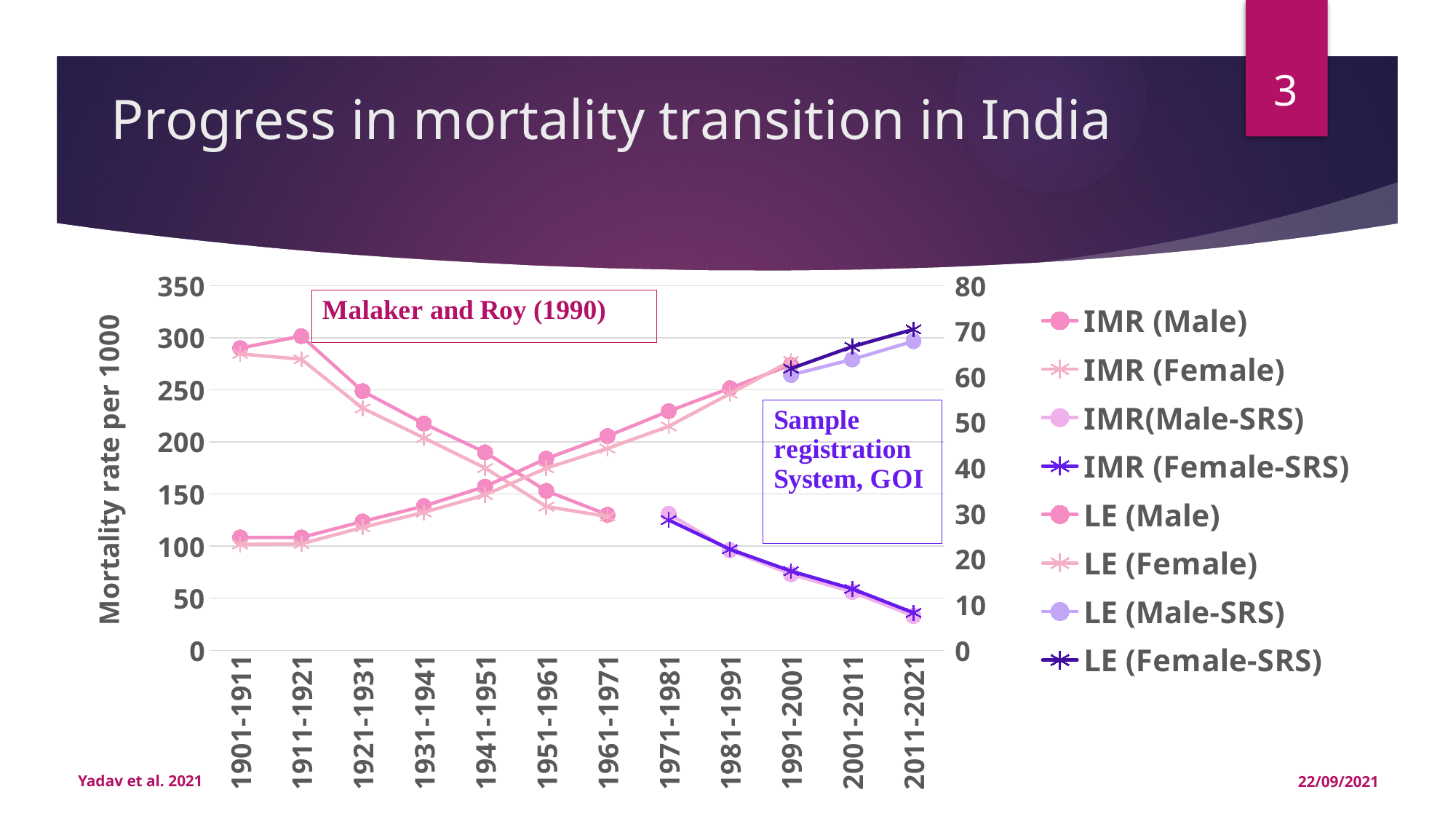
Is the IMR (Female) value for 1961-1971 greater or less than 150 on the left axis? less Is the IMR (Male) value for 1901-1911 greater or less than 250 on the left axis? greater Does the LE (Male) series rise or fall from 1901-1911 to 1991-2001? rise How many series does the legend list? 8 Is the IMR (Male) value for 1941-1951 greater or less than 200 on the left axis? less What source is named in the annotation box at the top of the chart? Malaker and Roy (1990) Does the IMR (Female) series rise or fall from 1901-1911 to 1961-1971? fall What is the title of the left vertical axis? Mortality rate per 1000 In which period is the IMR (Male) series at its highest? 1911-1921 What kind of chart is shown on the slide? line chart How many time periods are shown on the x axis? 12